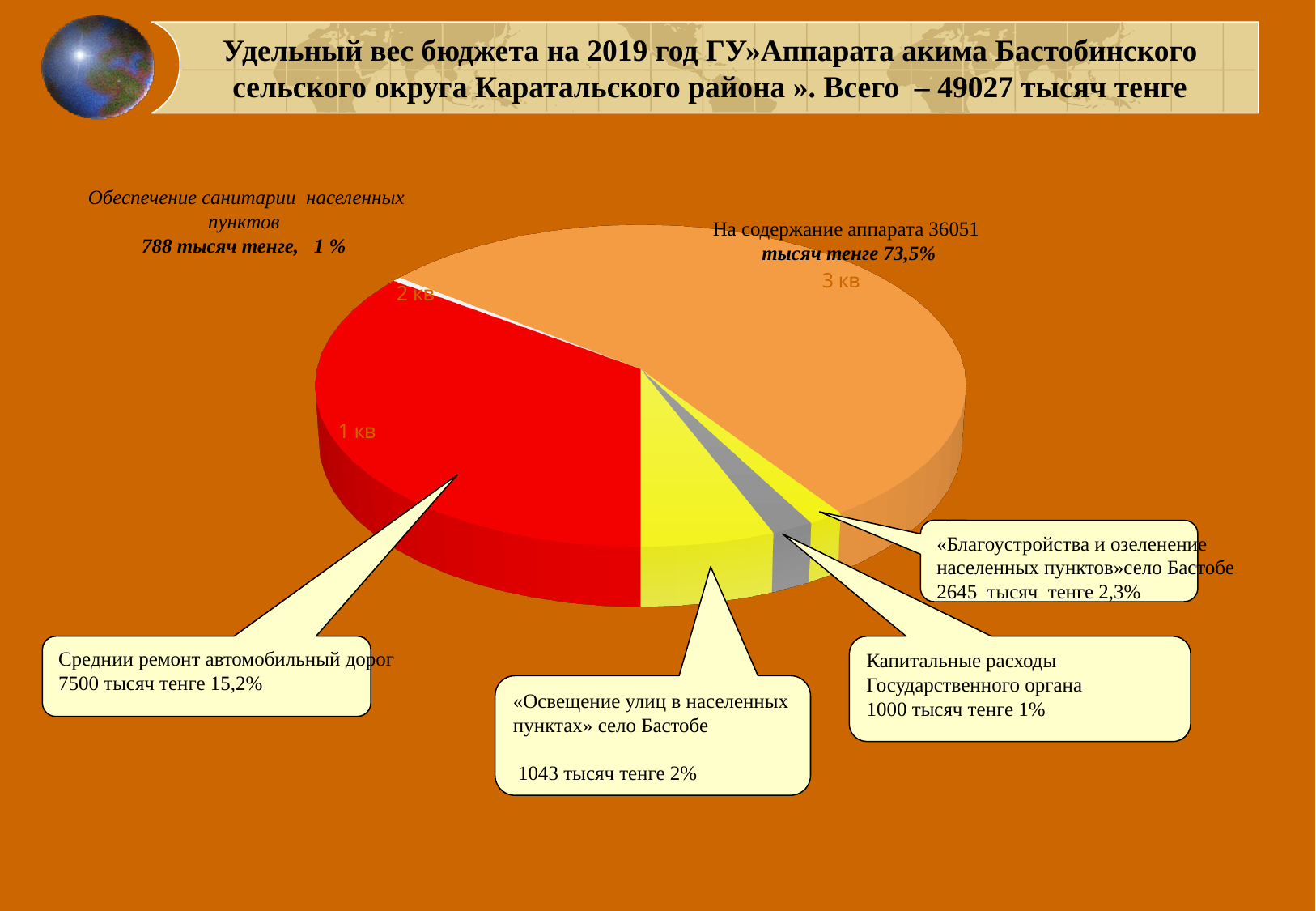
What is the difference in thousand tenge between «На содержание аппарата» and «Среднии ремонт автомобильный дорог»? 28551 What percentage is shown for «Благоустройства и озеленение населенных пунктов» село Бастобе? 2,3% What is the value for «Капитальные расходы Государственного органа»? 1000 тысяч тенге What kind of chart is shown on the slide? pie chart Which budget item has the smallest value? Обеспечение санитарии населенных пунктов What is the total budget stated in the slide title? 49027 тысяч тенге How many thousand tenge are allocated to «На содержание аппарата»? 36051 тысяч тенге What is the value for «Среднии ремонт автомобильный дорог»? 7500 тысяч тенге Which budget item has the largest value? На содержание аппарата What is the value for «Освещение улиц в населенных пунктах» село Бастобе? 1043 тысяч тенге Which is larger: «Освещение улиц в населенных пунктах» or «Капитальные расходы Государственного органа»? Освещение улиц в населенных пунктах What share of the budget does «На содержание аппарата» represent? 73,5%